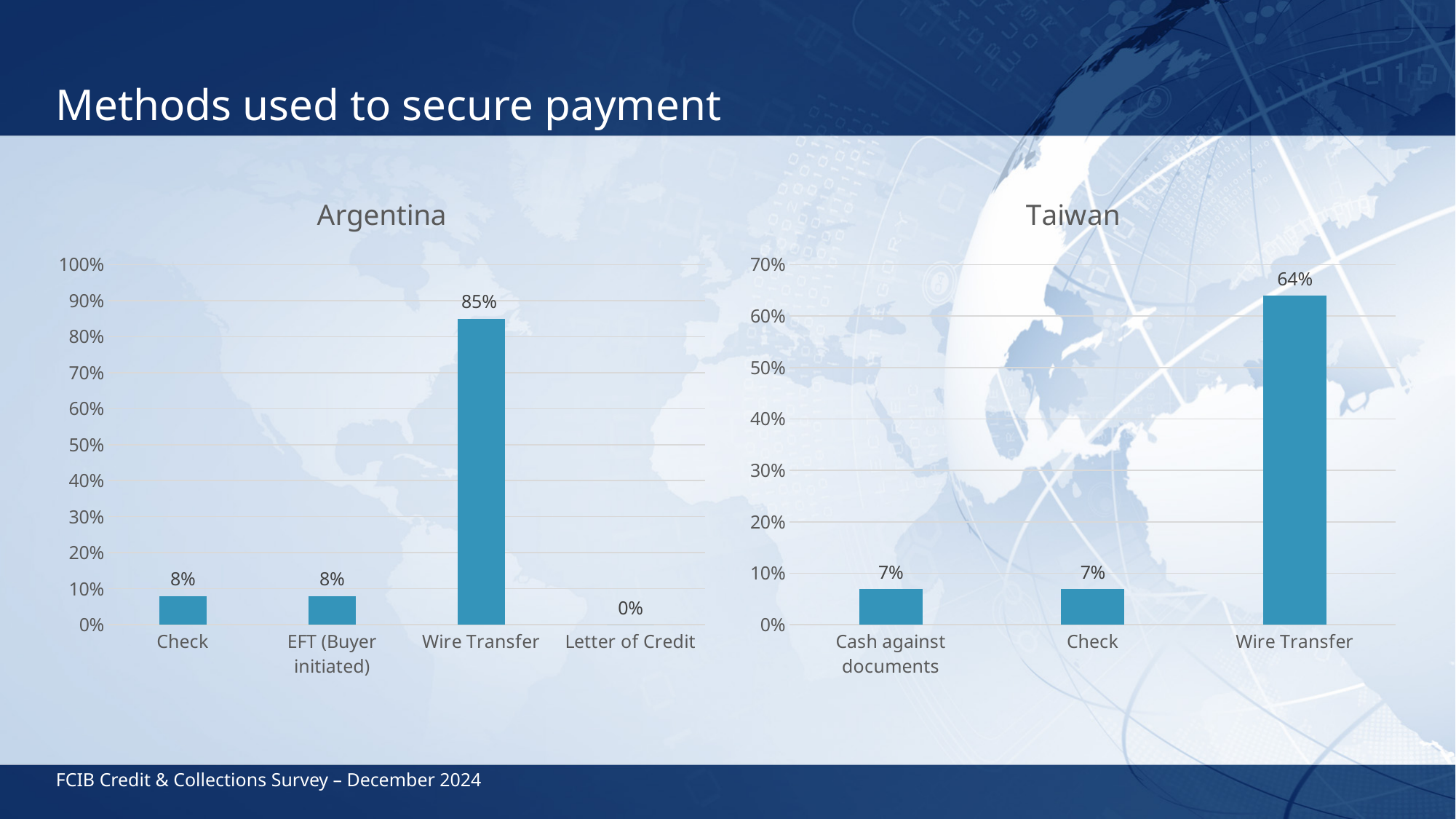
In the Taiwan chart, what is the value for Wire Transfer? 64% How many categories are shown in the Argentina chart? 4 In the Argentina chart, what is the difference between the values for Wire Transfer and Check? 77% In the Taiwan chart, what is the difference between the values for Wire Transfer and Check? 57% In the Argentina chart, which category has the lowest value? Letter of Credit Which is larger: Wire Transfer in the Argentina chart or Wire Transfer in the Taiwan chart? Argentina In the Taiwan chart, what is the value for Cash against documents? 7% In the Argentina chart, what is the value for Wire Transfer? 85% In the Argentina chart, which category has the highest value? Wire Transfer In the Argentina chart, what is the value for Letter of Credit? 0% In the Taiwan chart, which category has the highest value? Wire Transfer What kind of chart is the Taiwan chart? Bar chart